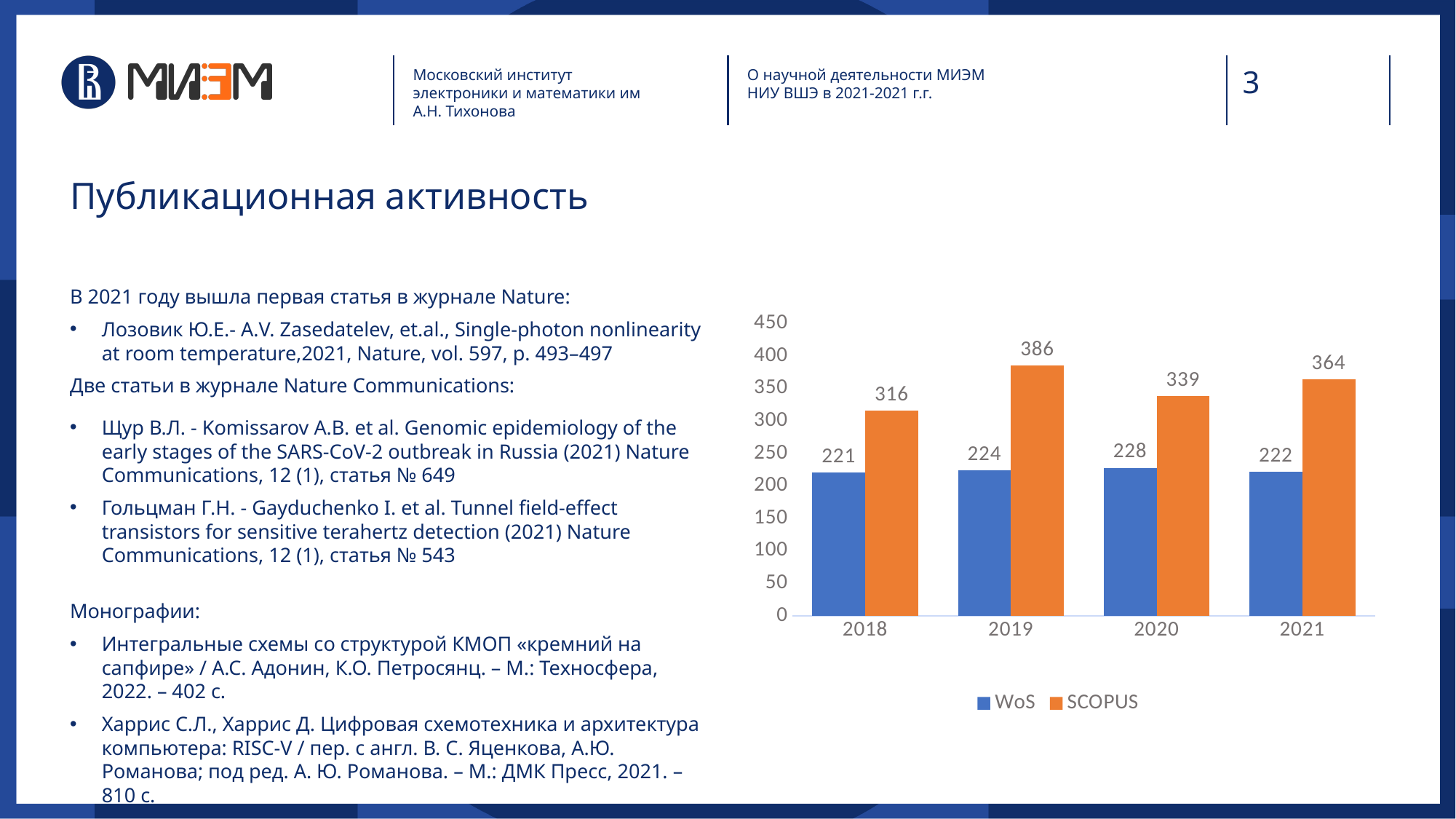
What is the SCOPUS value for 2019? 386 What is the WoS value for 2018? 221 How many years are shown on the x axis? 4 What is the SCOPUS value for 2021? 364 In which year is the SCOPUS value highest? 2019 What kind of chart is shown on the slide? Bar chart What is the difference between the SCOPUS and WoS values in 2019? 162 In which year is the SCOPUS value lowest? 2018 Which colour represents the SCOPUS series? Orange Which is larger in 2021, the WoS value or the SCOPUS value? SCOPUS What is the WoS value for 2020? 228 How many series does the legend list? 2